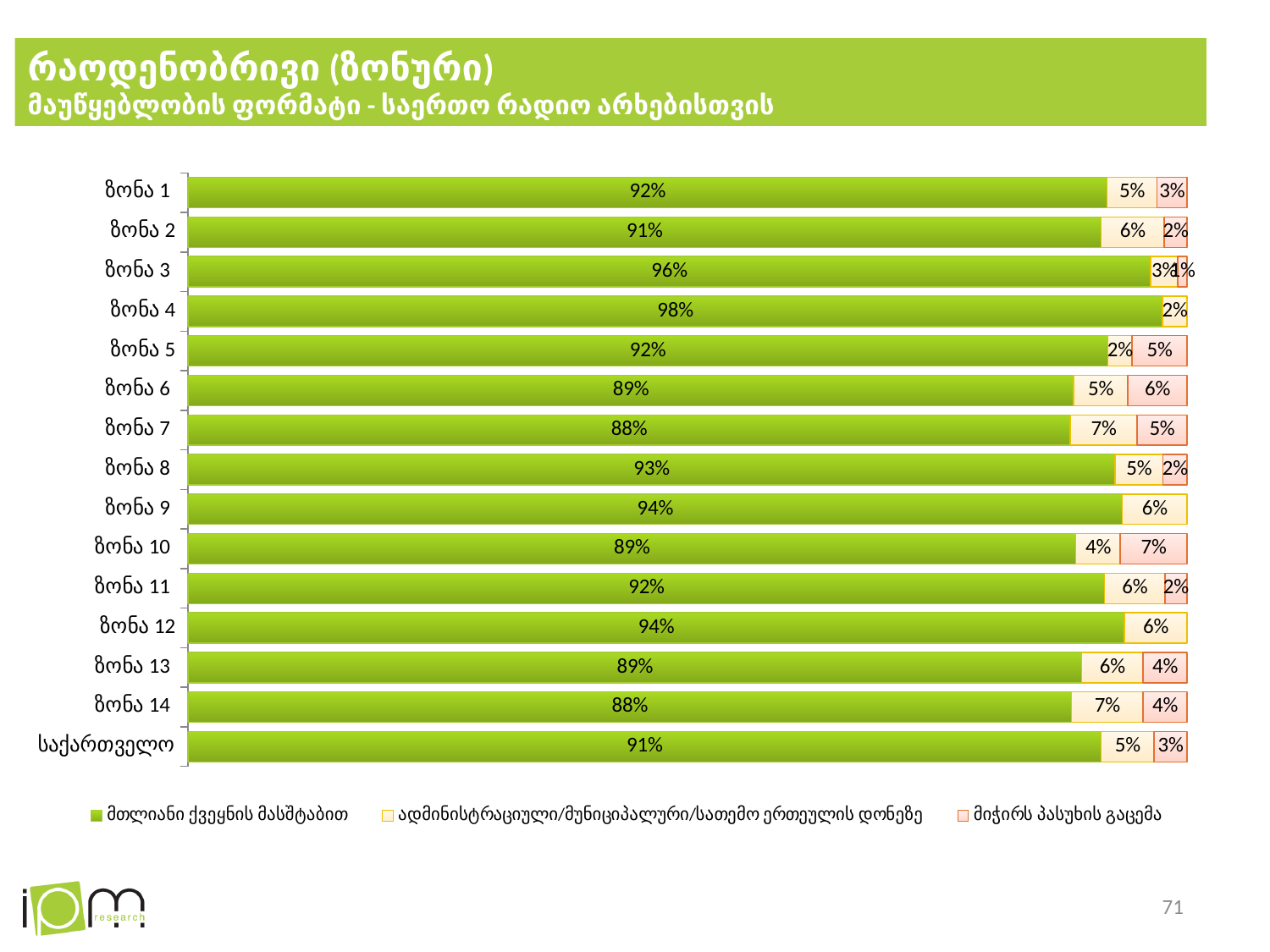
What type of chart is shown on the slide? bar chart What is the total of the stacked bar for ზონა 1? 100% What is the value of the green series (მთლიანი ქვეყნის მასშტაბით) for საქართველო? 91% What is the value of the green series (მთლიანი ქვეყნის მასშტაბით) for ზონა 4? 98% Which is larger for the green series: ზონა 3 or ზონა 6? ზონა 3 Which category has the highest value for the green series (მთლიანი ქვეყნის მასშტაბით)? ზონა 4 What is the value of the pink series (მიჭირს პასუხის გაცემა) for ზონა 10? 7% What is the difference between the green series values for ზონა 4 and ზონა 7? 10% How many categories are plotted on the chart? 15 Which category has the highest value for the pink series (მიჭირს პასუხის გაცემა)? ზონა 10 What is the value of the yellow series (ადმინისტრაციული/მუნიციპალური/სათემო ერთეულის დონეზე) for ზონა 14? 7% How many series does the legend list? 3